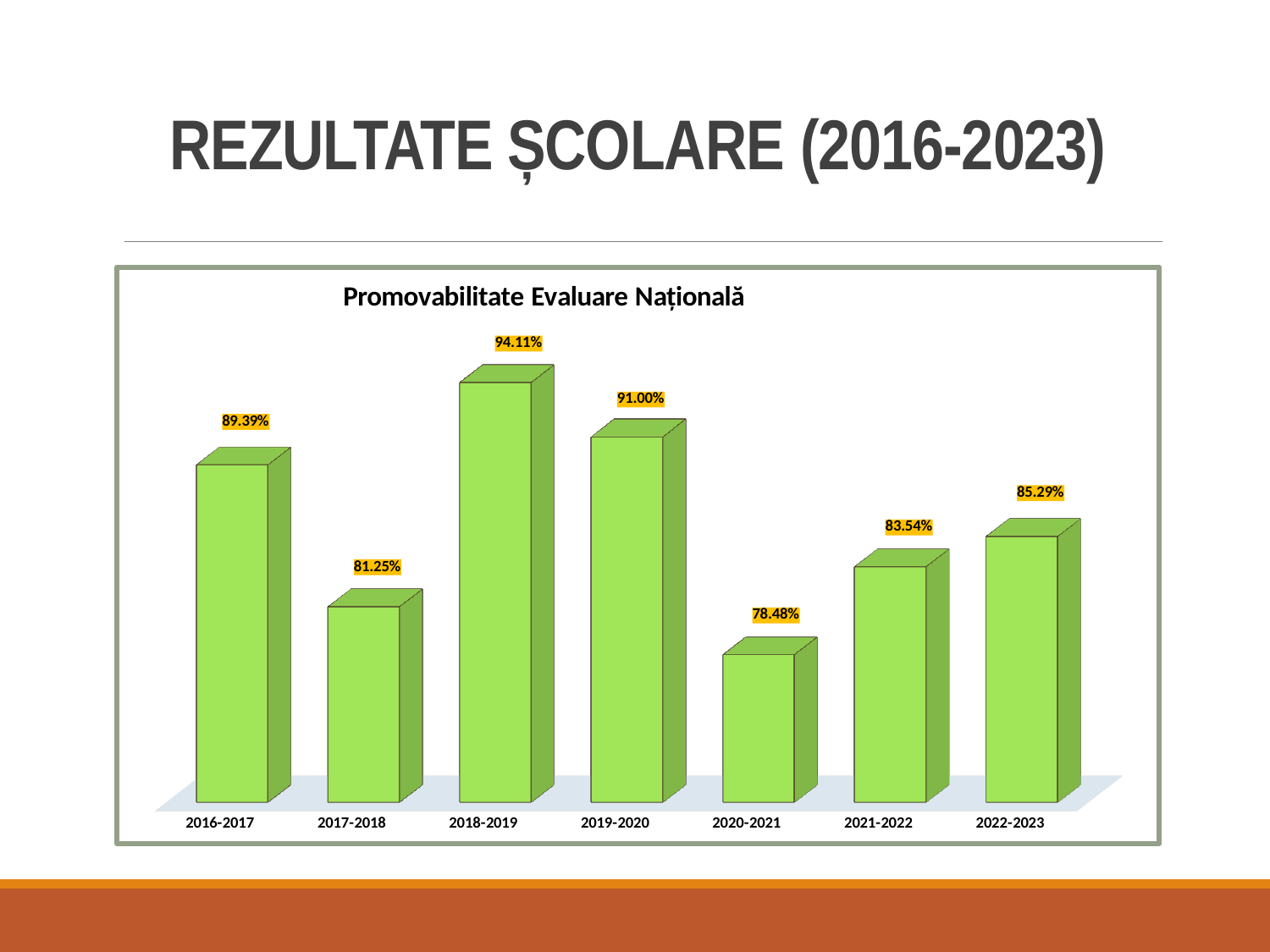
Which school year has the lowest value? 2020-2021 Do the values rise or fall from 2020-2021 to 2022-2023? rise What is the difference between the values for 2019-2020 and 2017-2018? 9.75% What is the value for 2020-2021? 78.48% What is the title of the chart? Promovabilitate Evaluare Națională Which school year has the highest value? 2018-2019 How many school years are shown on the chart? 7 What is the difference between the values for 2018-2019 and 2020-2021? 15.63% What is the value for 2022-2023? 85.29% Which is larger, the value for 2021-2022 or the value for 2022-2023? 2022-2023 What kind of chart is shown on the slide? bar chart What is the value for 2016-2017? 89.39%